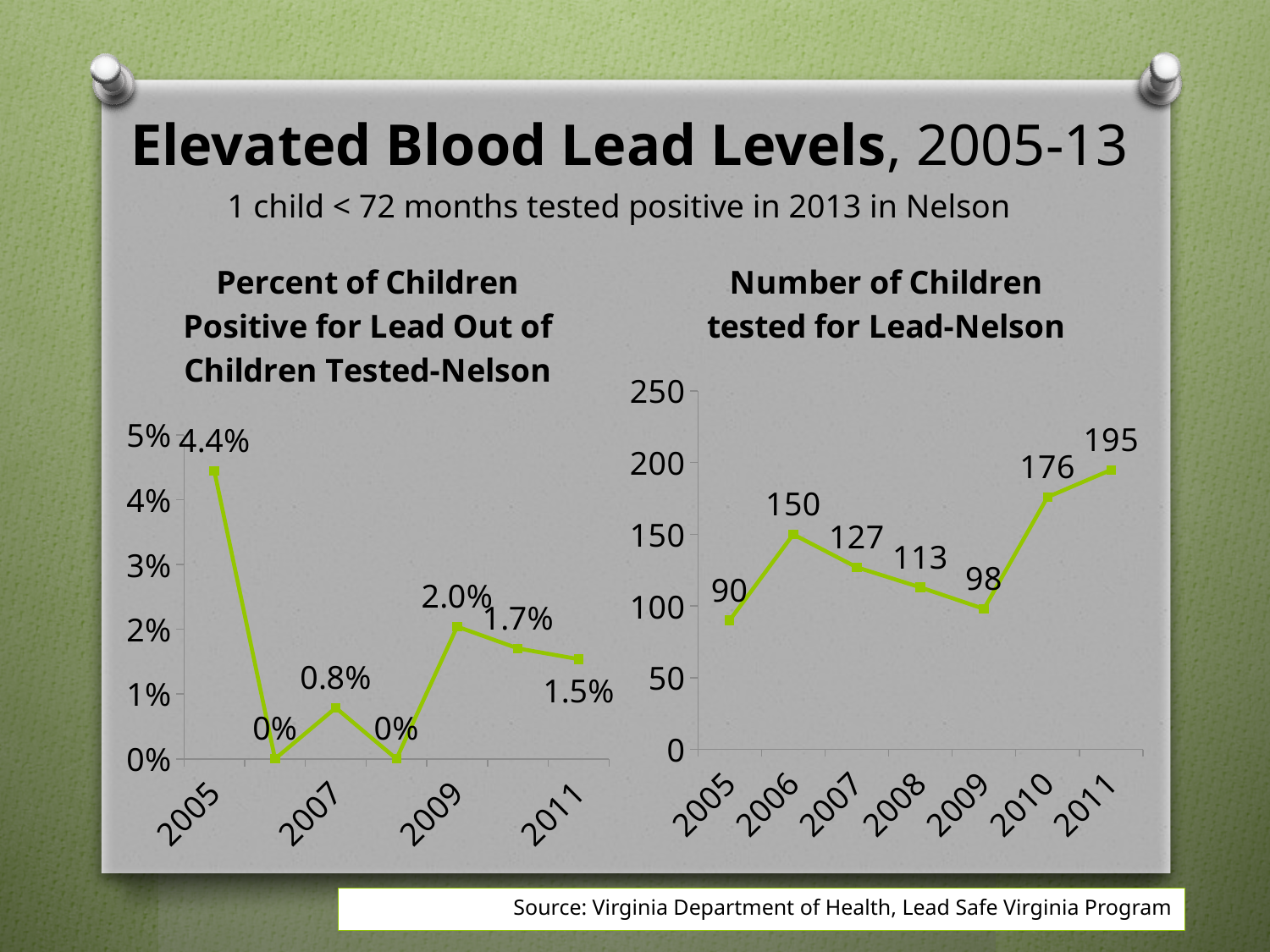
What type of chart is the 'Number of Children tested for Lead-Nelson' chart? Line chart In the 'Number of Children tested for Lead-Nelson' chart, is the value for 2010 greater or less than 150? greater In the 'Percent of Children Positive for Lead Out of Children Tested-Nelson' chart, what is the difference between the 2009 value and the 2011 value? 0.5% In the 'Percent of Children Positive for Lead Out of Children Tested-Nelson' chart, what is the value for 2005? 4.4% In the 'Number of Children tested for Lead-Nelson' chart, which year has the highest number of children tested? 2011 In the 'Number of Children tested for Lead-Nelson' chart, which year had more children tested, 2006 or 2009? 2006 In the 'Number of Children tested for Lead-Nelson' chart, what is the difference between the number tested in 2011 and in 2010? 19 In the 'Number of Children tested for Lead-Nelson' chart, how many children were tested in 2008? 113 In the 'Percent of Children Positive for Lead Out of Children Tested-Nelson' chart, what is the value for 2011? 1.5% In the 'Number of Children tested for Lead-Nelson' chart, how many data points are plotted? 7 In the 'Percent of Children Positive for Lead Out of Children Tested-Nelson' chart, which year has the highest percentage? 2005 In the 'Number of Children tested for Lead-Nelson' chart, which year has the lowest number of children tested? 2005